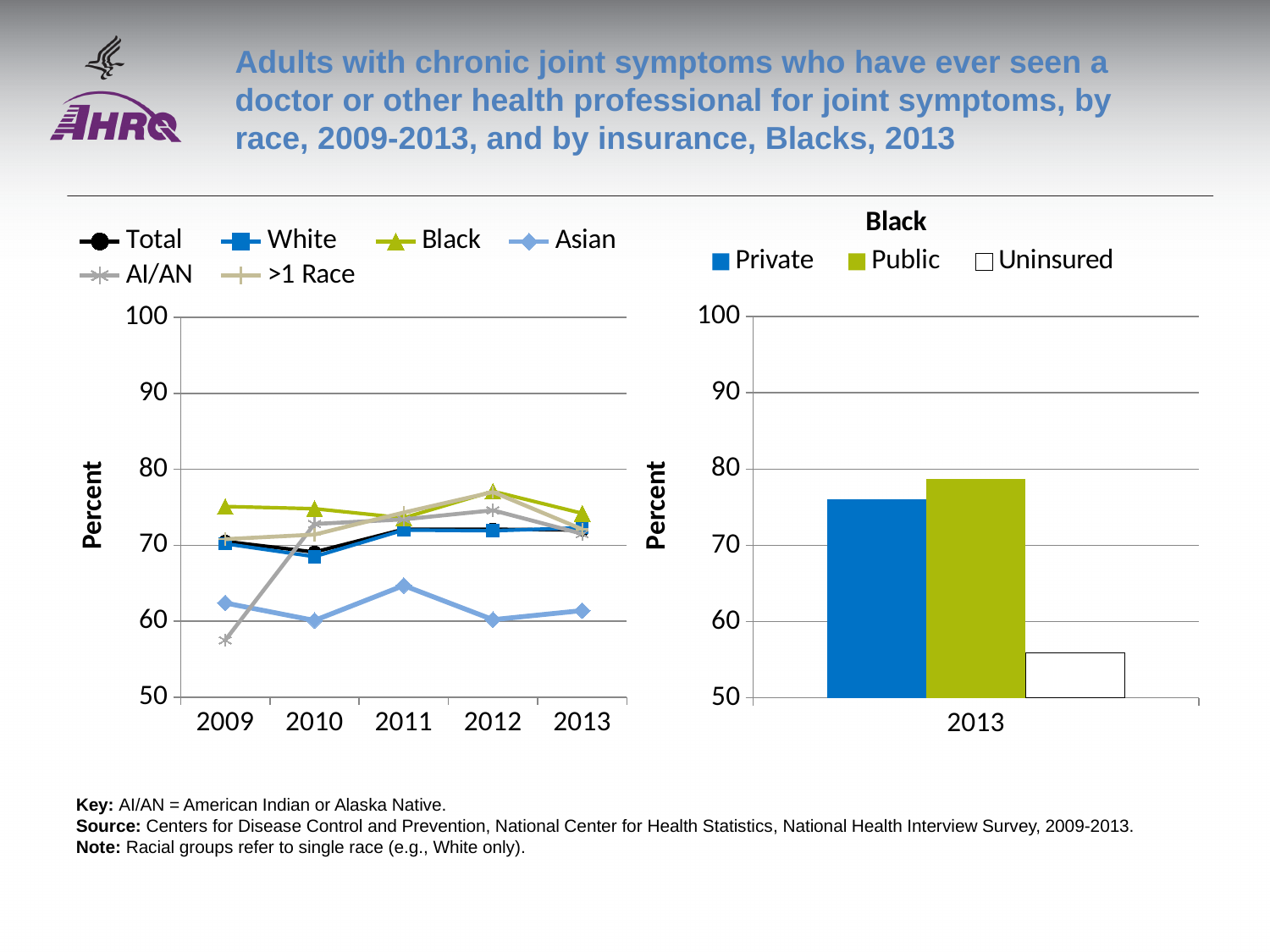
In the left chart (by race), which group has the lowest value in 2009? AI/AN In the right chart titled "Black", is the value for Private greater or less than 70? greater In the right chart titled "Black", which insurance group has the lowest value? Uninsured In the left chart (by race), is the value for Asian in 2011 greater or less than 70? less In the left chart (by race), which is larger in 2013, the value for Black or the value for Asian? Black How many series does the legend of the left chart (by race) list? 6 What kind of chart is the right chart titled "Black"? bar chart How many series does the legend of the right chart titled "Black" list? 3 In the right chart titled "Black", which insurance group has the highest value? Public How many years are shown on the x axis of the left chart (by race)? 5 What kind of chart is the left chart showing rates by race, 2009-2013? line chart In the right chart titled "Black", is the value for Uninsured greater or less than 60? less